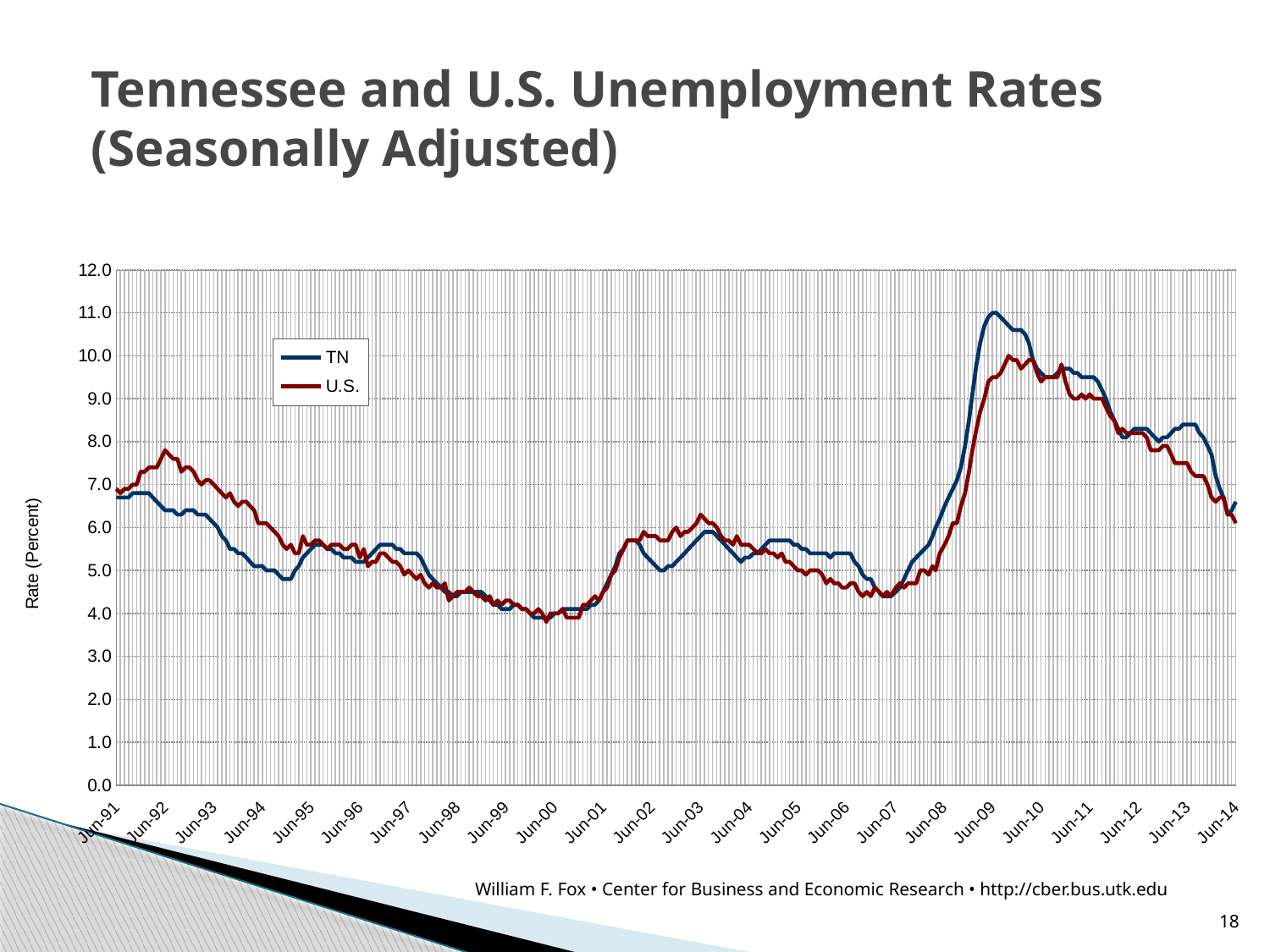
Which series reaches the highest value on the chart? TN How many series does the legend list? 2 Between Jun-07 and Jun-09, does the TN line rise or fall? rise Is the peak value of the TN line greater or less than 10.0? greater What is the label on the vertical axis? Rate (Percent) Is the TN value at Jun-00 greater or less than 5.0? less At Jun-09, which series has the higher value, TN or U.S.? TN What kind of chart is shown on the slide? Line chart Near which x-axis label does the TN line reach its peak? Jun-09 What are the two series named in the legend? TN and U.S. At Jun-92, which series has the higher value, TN or U.S.? U.S. Is the U.S. value at Jun-09 greater or less than 9.0? greater